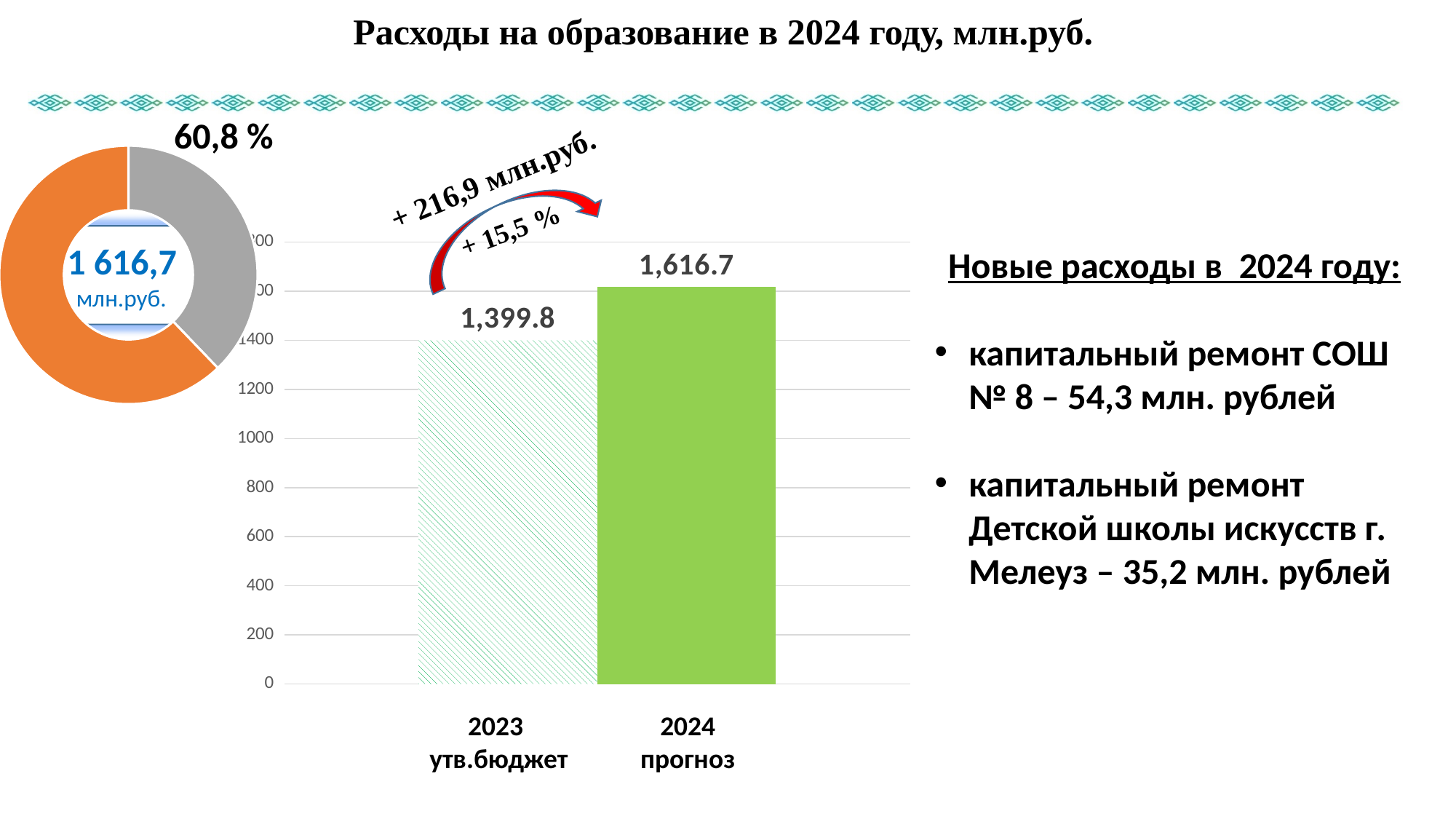
What value is printed in the centre of the donut chart on the left? 1 616,7 млн.руб. In the bar chart, which is larger: the value for 2023 утв.бюджет or the value for 2024 прогноз? 2024 прогноз In the bar chart, what is the value for 2024 прогноз? 1,616.7 In the bar chart, do the values rise or fall from 2023 to 2024? rise In the bar chart, what is the difference between the 2024 прогноз value and the 2023 утв.бюджет value? 216.9 In the bar chart, which category has the highest value? 2024 прогноз In the bar chart, is the value for 2023 утв.бюджет greater or less than 1400? less In the bar chart, what is the value for 2023 утв.бюджет? 1,399.8 How many bars are shown in the bar chart? 2 What percentage increase is written on the arrow annotation above the bar chart? + 15,5 % What kind of chart is the chart in the middle of the slide? bar chart In the bar chart, which category has the lowest value? 2023 утв.бюджет